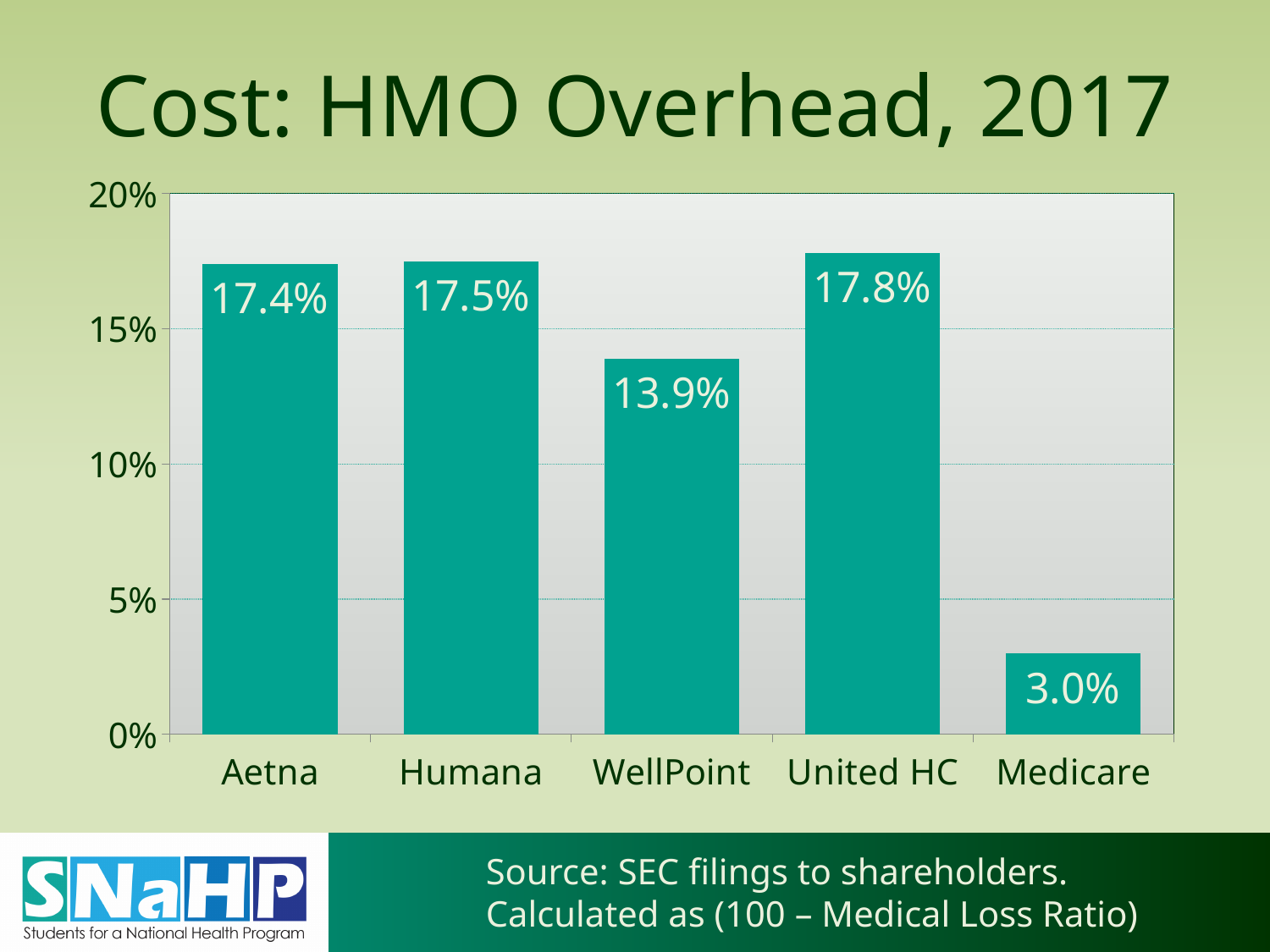
What is the overhead value for WellPoint? 13.9% What is the overhead value for Medicare? 3.0% Which category has the lowest overhead? Medicare Which category has the highest overhead? United HC What is the overhead value for Aetna? 17.4% What kind of chart is shown on the slide? bar chart How many categories are shown on the x axis? 5 Is the value for WellPoint greater or less than 15%? less What is the title of the chart? Cost: HMO Overhead, 2017 Which has a larger overhead, WellPoint or Aetna? Aetna What is the difference between the overhead for Humana and WellPoint? 3.6% What is the difference between the overhead for United HC and Medicare? 14.8%